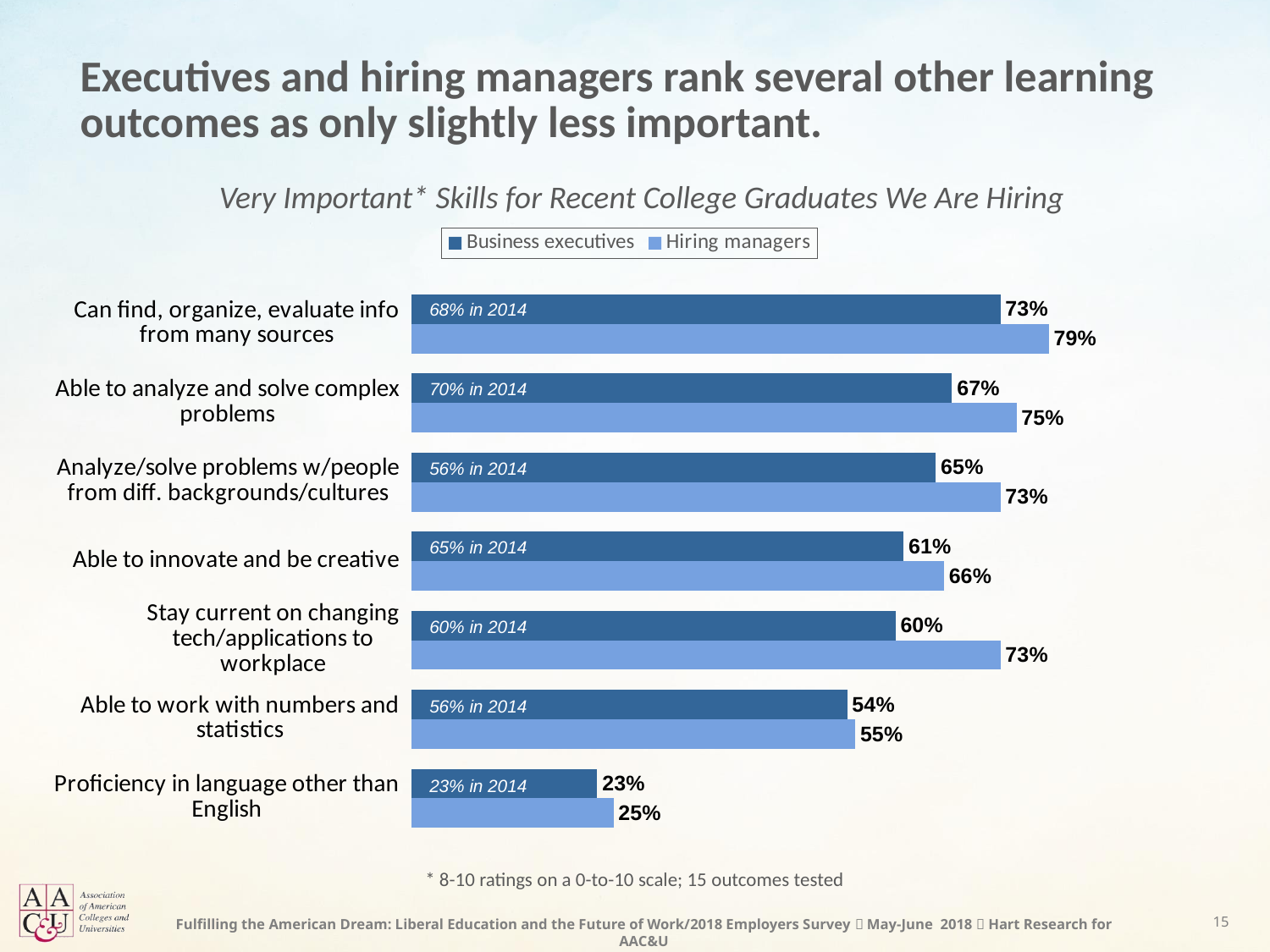
Which skill has the highest hiring managers value? Can find, organize, evaluate info from many sources What was the 2014 value shown for 'Analyze/solve problems w/people from diff. backgrounds/cultures'? 56% in 2014 Which is larger for 'Able to work with numbers and statistics': the business executives value or the hiring managers value? Hiring managers What kind of chart is shown on the slide? Bar chart What is the hiring managers value for 'Able to innovate and be creative'? 66% Which skill has the lowest business executives value? Proficiency in language other than English What percentage of hiring managers rate 'Able to analyze and solve complex problems' as very important? 75% What is the difference between the hiring managers and business executives values for 'Stay current on changing tech/applications to workplace'? 13 percentage points How many series does the legend list? 2 What percentage of business executives rate 'Can find, organize, evaluate info from many sources' as very important? 73% How many skills are listed on the chart? 7 What is the title of the chart? Very Important* Skills for Recent College Graduates We Are Hiring